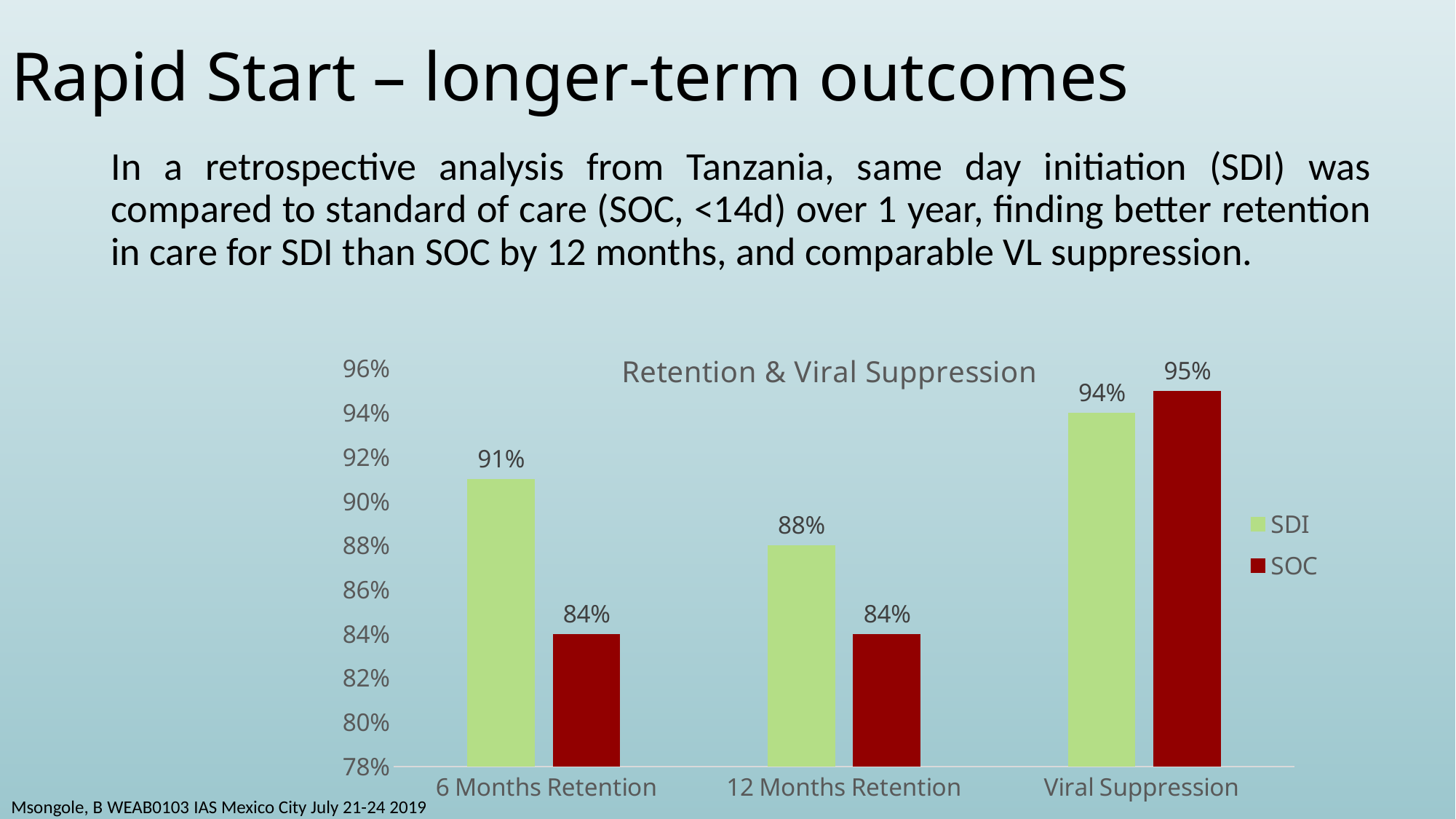
Which is larger for Viral Suppression, the SDI value or the SOC value? SOC What is the SDI value for 12 Months Retention? 88% What is the difference between the SDI and SOC values for 6 Months Retention? 7% Which category has the highest SDI value? Viral Suppression How many series does the legend list? 2 What kind of chart is shown on the slide? Bar chart Which category has the lowest SDI value? 12 Months Retention How many categories are shown on the x axis? 3 What is the SOC value for 12 Months Retention? 84% What is the SDI value for 6 Months Retention? 91% What is the SOC value for Viral Suppression? 95% What is the title of the chart? Retention & Viral Suppression